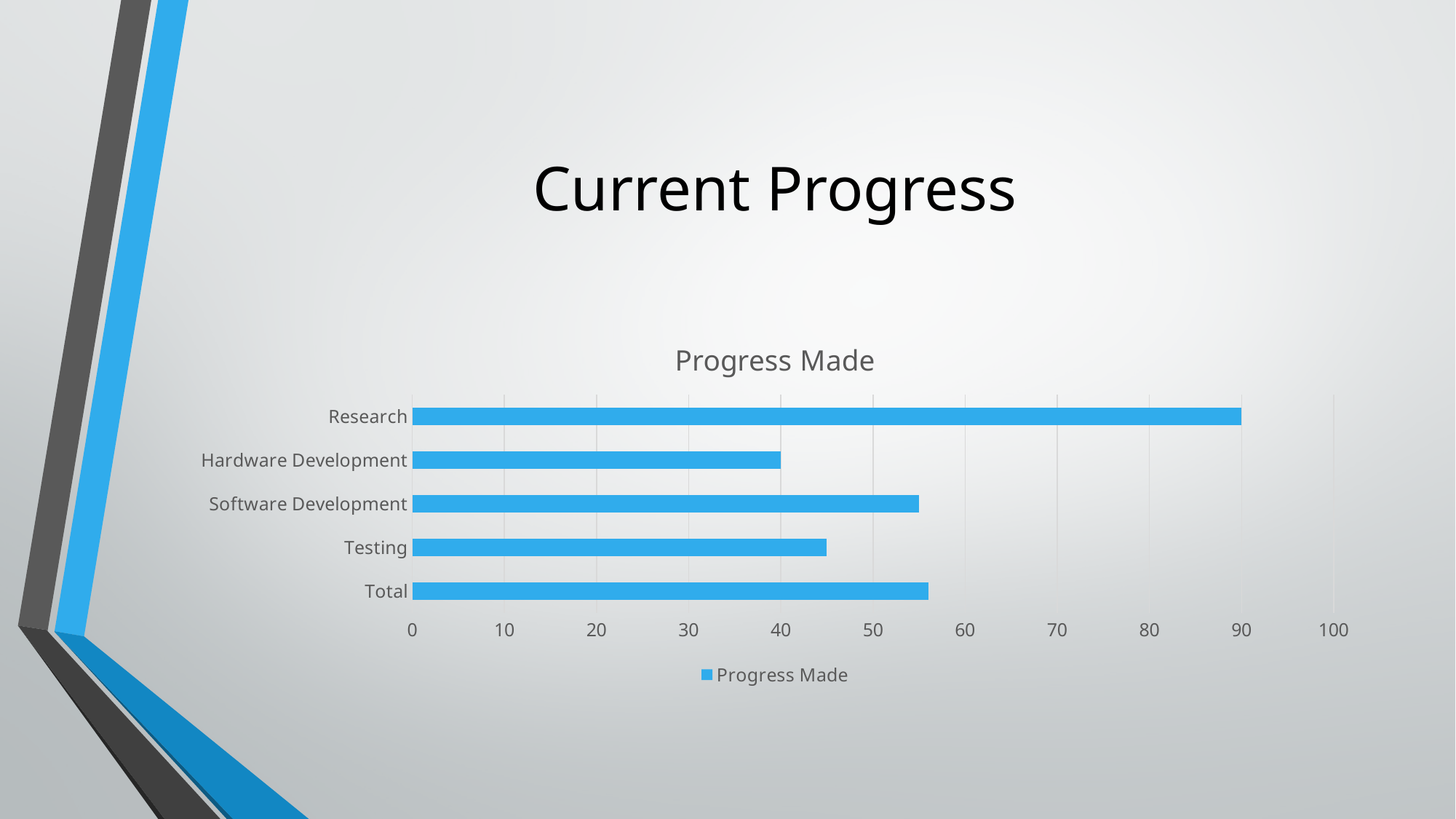
Is the value for Software Development greater or less than 50? greater What is the value for Research in the Progress Made chart? 90 Is the value for Testing greater or less than 50? less What kind of chart is shown on the slide? Bar chart Which category has the highest value in the Progress Made chart? Research Which is larger, the value for Research or the value for Testing? Research Which category has the lowest value in the Progress Made chart? Hardware Development Is the value for Total greater or less than 60? less What is the difference between the values for Research and Hardware Development? 50 What is the value for Hardware Development in the Progress Made chart? 40 How many categories are shown in the Progress Made chart? 5 How many series does the legend of the chart list? 1